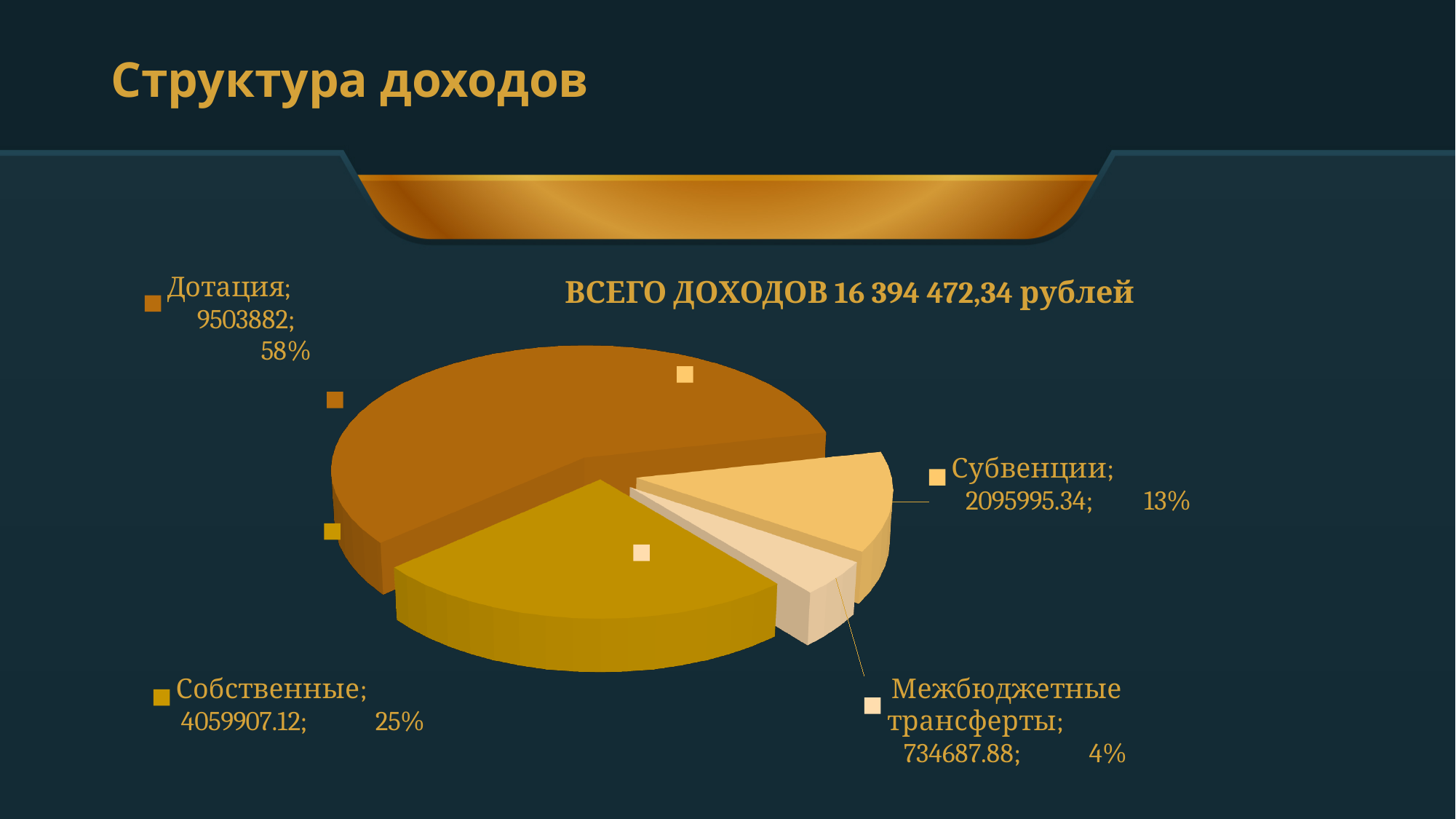
What is the title of the chart? ВСЕГО ДОХОДОВ 16 394 472,34 рублей What kind of chart is shown on the slide? pie chart What is the value for Собственные? 4059907.12 What share of the pie does Субвенции represent? 13% What is the value for Субвенции? 2095995.34 Which is larger, the value for Субвенции or the value for Межбюджетные трансферты? Субвенции What is the value for Дотация? 9503882 Which category has the smallest slice of the pie? Межбюджетные трансферты How many slices does the pie chart have? 4 What share of the pie does Собственные represent? 25% Which category has the largest slice of the pie? Дотация What is the value for Межбюджетные трансферты? 734687.88